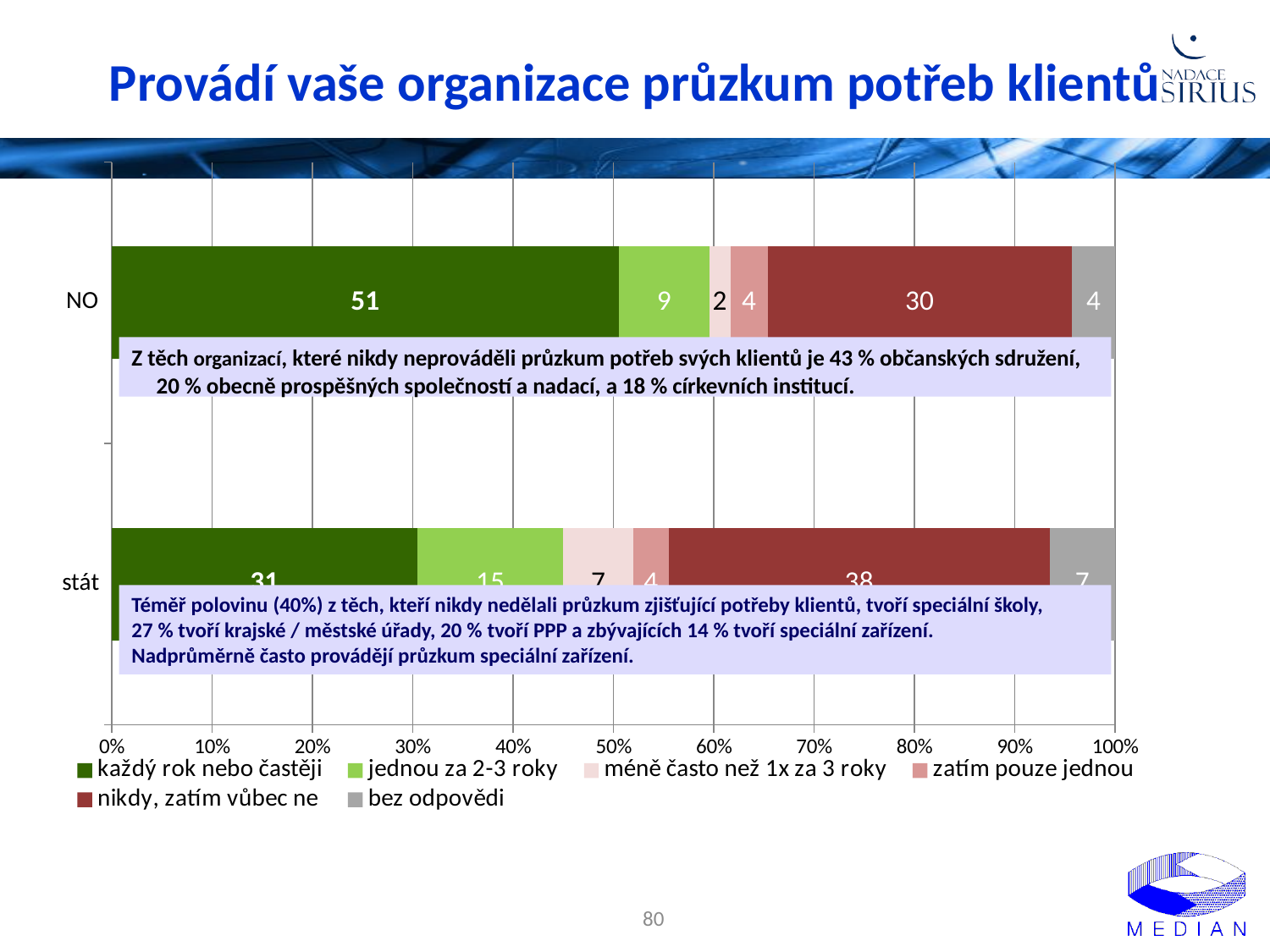
What is the value for 'bez odpovědi' in the NO bar? 4 What is the value for 'jednou za 2-3 roky' in the NO bar? 9 Which series has the largest segment in the NO bar? každý rok nebo častěji Which series has the smallest segment in the NO bar? méně často než 1x za 3 roky What is the value for 'každý rok nebo častěji' in the NO bar? 51 What kind of chart is shown on the slide? stacked bar chart Which category has the larger 'každý rok nebo častěji' segment, NO or stát? NO Is the 'každý rok nebo častěji' segment of the stát bar greater or less than 40%? less How many series does the legend list? 6 What is the difference between 'každý rok nebo častěji' and 'nikdy, zatím vůbec ne' in the NO bar? 21 What is the value for 'nikdy, zatím vůbec ne' in the NO bar? 30 How many categories (bars) does the chart show? 2